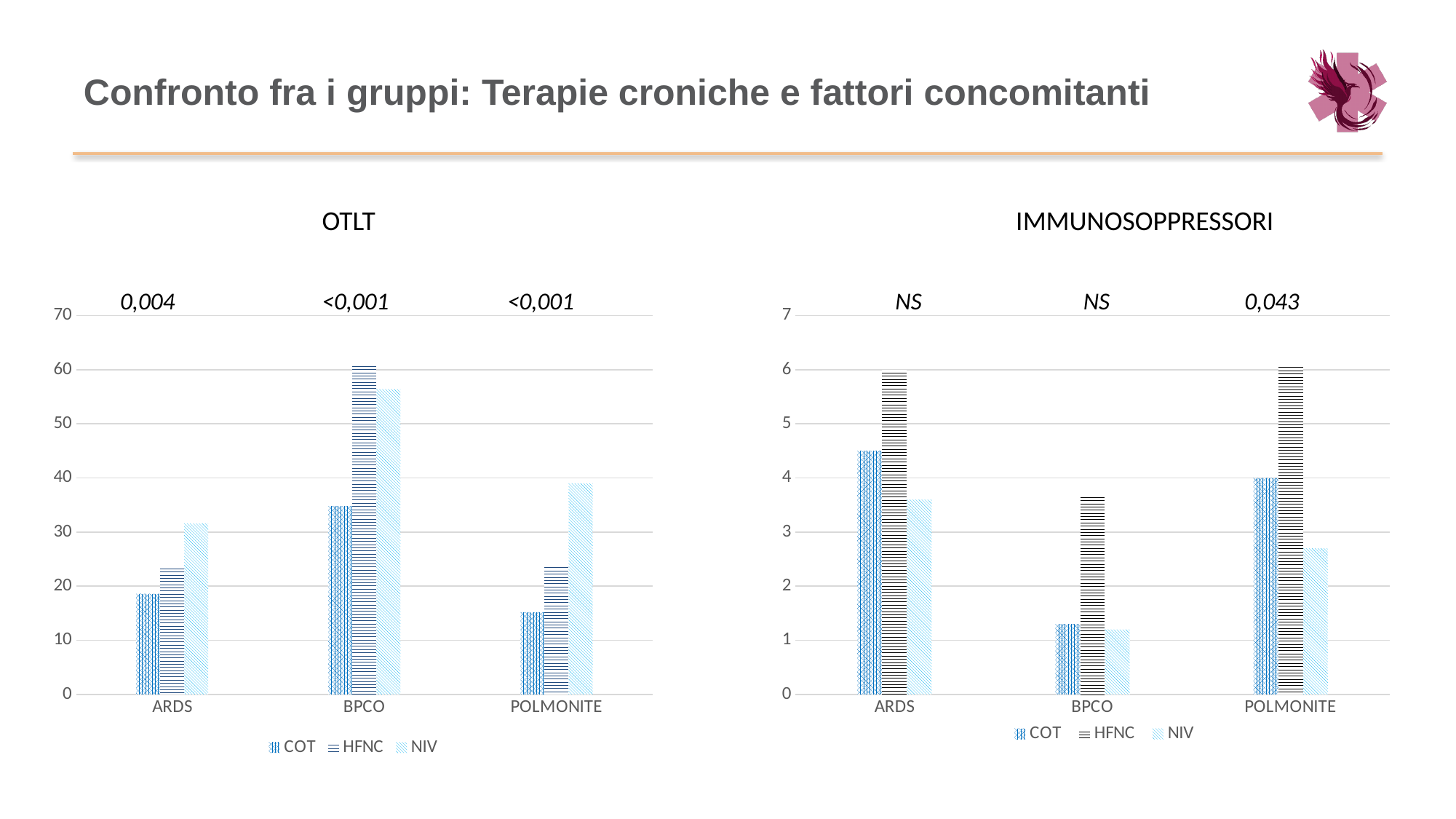
How many categories are shown on the x axis of the IMMUNOSOPPRESSORI chart? 3 How many series does the legend of the OTLT chart list? 3 In the OTLT chart, is the COT value for POLMONITE greater or less than 20? less In the IMMUNOSOPPRESSORI chart, for ARDS, which is larger: the HFNC bar or the NIV bar? HFNC In the IMMUNOSOPPRESSORI chart, is the NIV value for BPCO greater or less than 2? less In the OTLT chart, which category has the highest HFNC bar? BPCO In the IMMUNOSOPPRESSORI chart, which category has the lowest COT bar? BPCO In the IMMUNOSOPPRESSORI chart, what p-value annotation is printed above the POLMONITE group? 0,043 In the OTLT chart, for ARDS, which is larger: the NIV bar or the COT bar? NIV In the OTLT chart, is the HFNC value for BPCO greater or less than 50? greater What kind of chart is the OTLT chart? bar chart